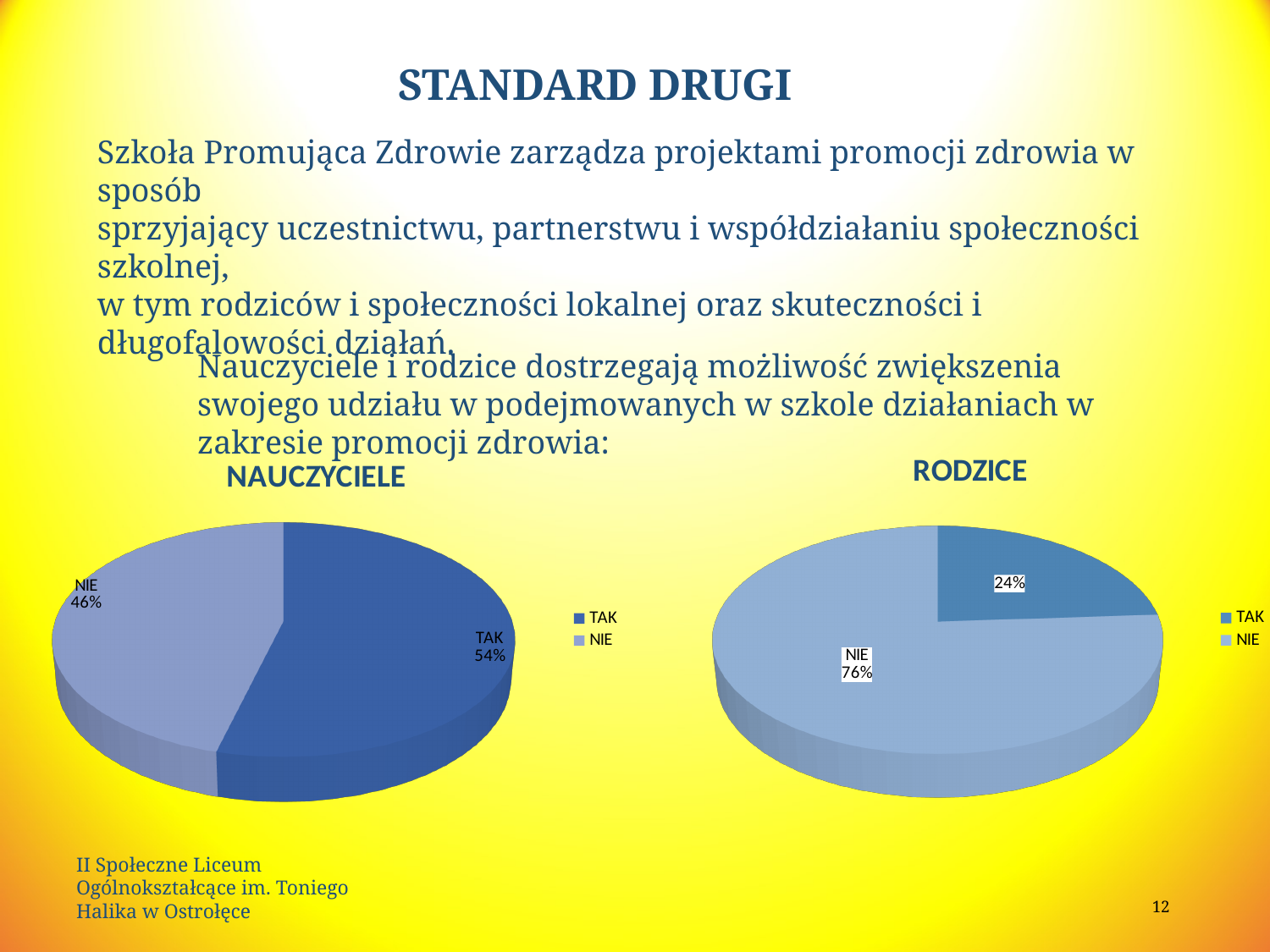
In the RODZICE chart, what percentage is shown for NIE? 76% In the RODZICE chart, which slice is the largest? NIE What type of chart is the NAUCZYCIELE chart? Pie chart In the RODZICE chart, what percentage is shown for the TAK slice? 24% How many entries does the legend of the NAUCZYCIELE chart list? 2 How many slices does the RODZICE chart have? 2 In the NAUCZYCIELE chart, what is the difference in percentage points between TAK and NIE? 8 In the NAUCZYCIELE chart, which slice is larger, TAK or NIE? TAK In the NAUCZYCIELE chart, what percentage is shown for TAK? 54% In the NAUCZYCIELE chart, what percentage is shown for NIE? 46% In the RODZICE chart, what is the difference in percentage points between NIE and TAK? 52 In the RODZICE chart, which slice is the smallest? TAK